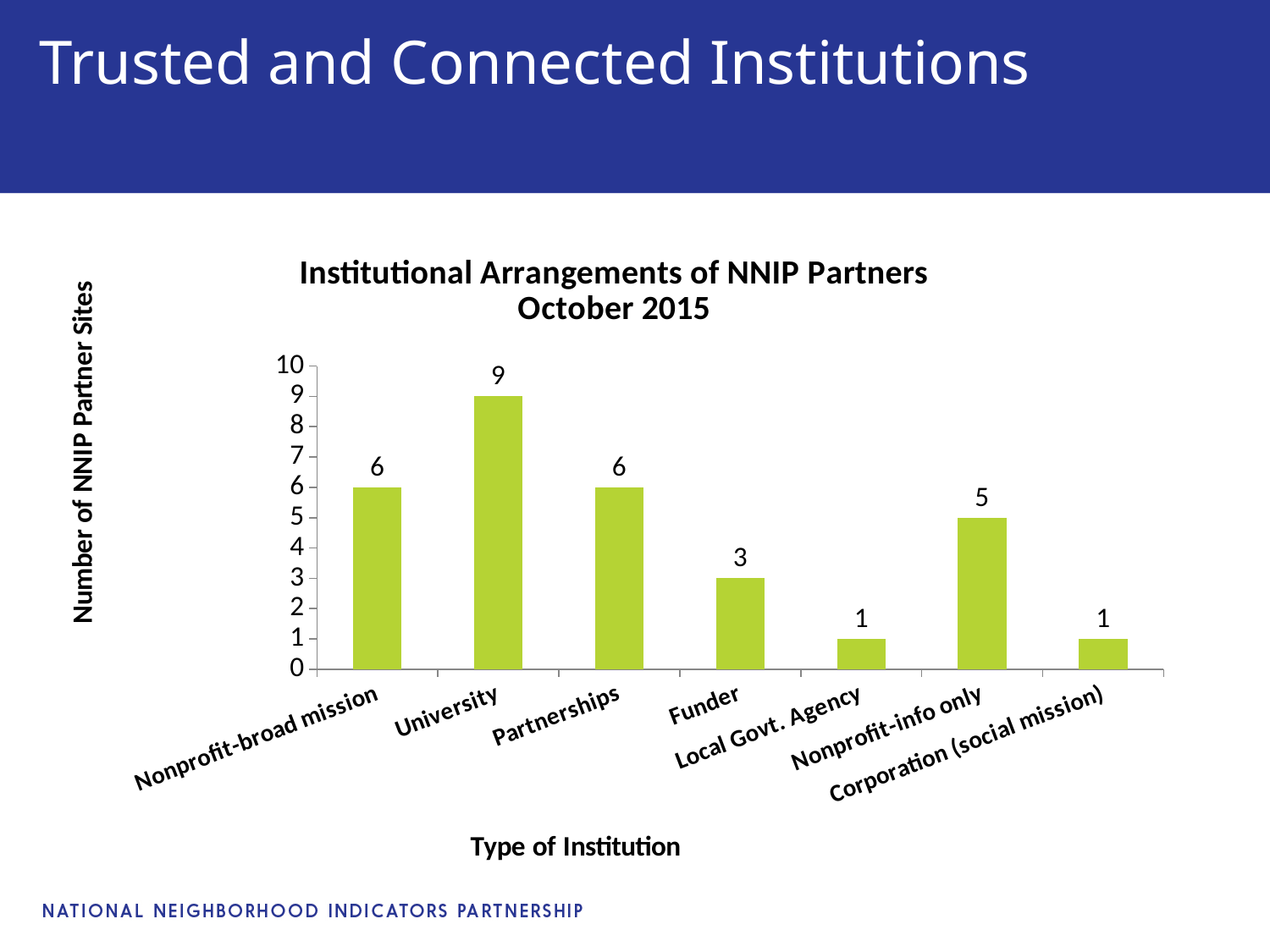
Which is larger, the value for Nonprofit-broad mission or the value for Nonprofit-info only? Nonprofit-broad mission What is the value for Nonprofit-info only? 5 What is the title of the chart? Institutional Arrangements of NNIP Partners October 2015 What is the value for Funder? 3 What kind of chart is this? Bar chart What is the label of the y axis? Number of NNIP Partner Sites How many types of institution are shown on the x axis? 7 What is the value for Local Govt. Agency? 1 What is the difference between the values for Nonprofit-info only and Funder? 2 What is the value for University? 9 What is the difference between the values for University and Partnerships? 3 Which type of institution has the highest number of NNIP partner sites? University